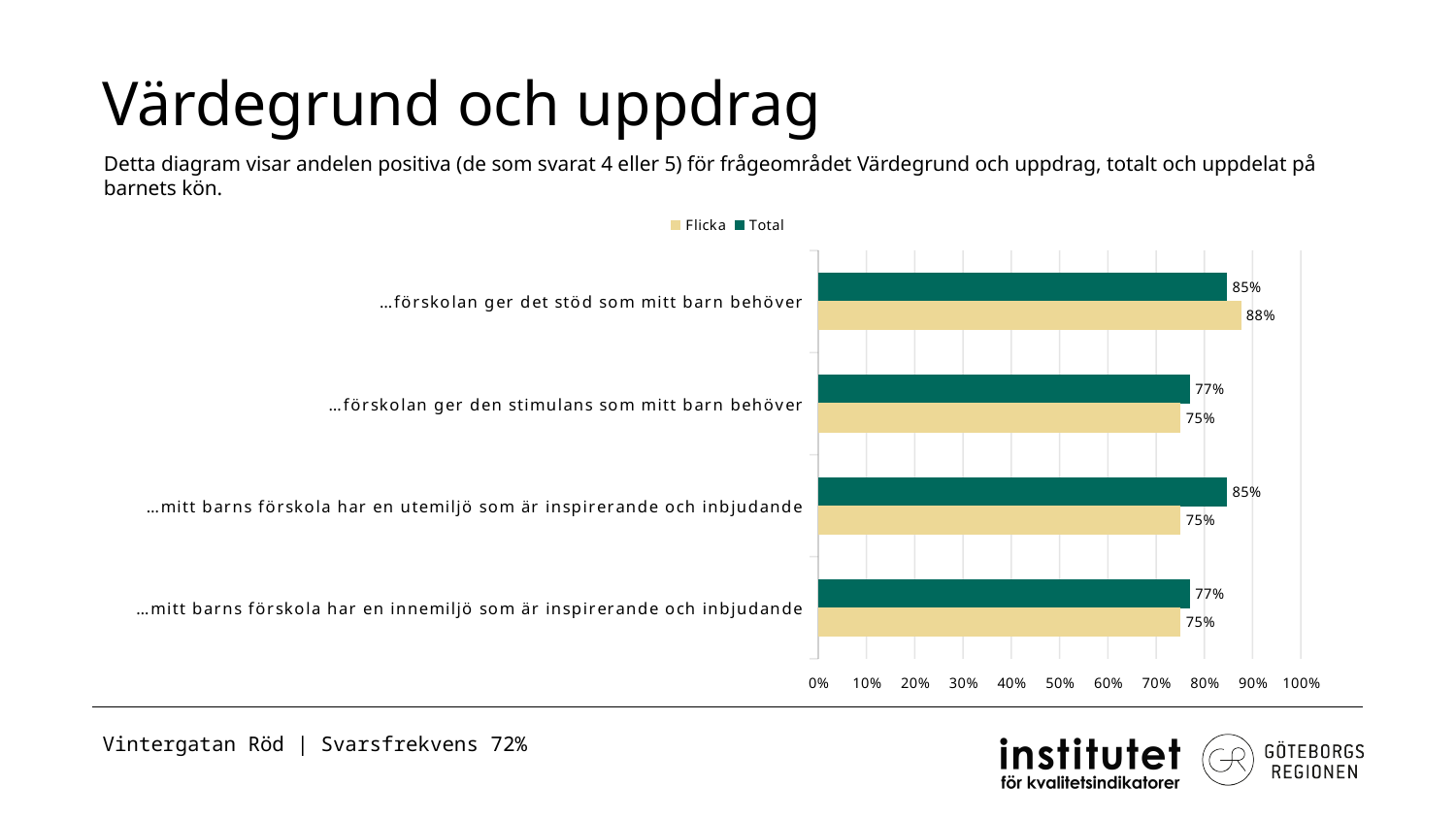
What is the Total value for "…mitt barns förskola har en innemiljö som är inspirerande och inbjudande"? 77% What kind of chart is shown on the slide? Bar chart Which category has the highest Flicka value? …förskolan ger det stöd som mitt barn behöver For "…förskolan ger den stimulans som mitt barn behöver", which is larger, the Flicka value or the Total value? Total What is the Flicka value for "…förskolan ger det stöd som mitt barn behöver"? 88% What is the Flicka value for "…förskolan ger den stimulans som mitt barn behöver"? 75% What is the difference between the Total and Flicka values for "…mitt barns förskola har en utemiljö som är inspirerande och inbjudande"? 10% How many categories are shown in the chart? 4 How many series does the legend list? 2 What is the Total value for "…mitt barns förskola har en utemiljö som är inspirerande och inbjudande"? 85% For "…förskolan ger det stöd som mitt barn behöver", which is larger, the Flicka value or the Total value? Flicka Which series is shown in green? Total